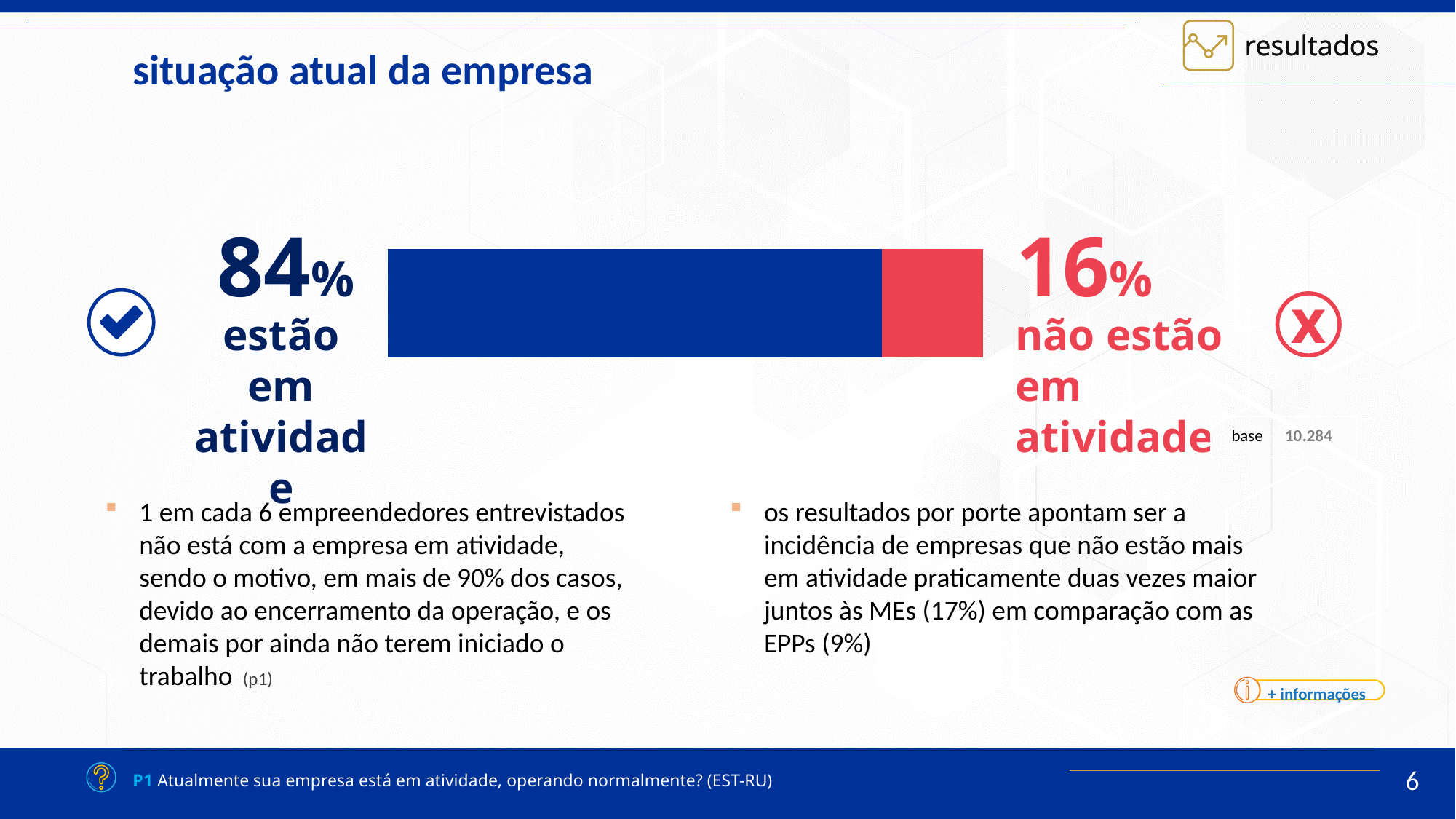
How many segments does the bar have? 2 What is the base (number of respondents) shown next to the chart? 10.284 Which category has the highest value on the chart? estão em atividade What percentage of companies are shown as 'não estão em atividade'? 16% Which category has the lowest value on the chart? não estão em atividade What colour is the segment representing 'não estão em atividade'? red What percentage of companies are shown as 'estão em atividade'? 84% What is the total of the two segments of the stacked bar? 100% What is the difference in percentage points between 'estão em atividade' and 'não estão em atividade'? 68 What kind of chart is shown on the slide? bar chart Which segment of the bar is larger, 'estão em atividade' or 'não estão em atividade'? estão em atividade